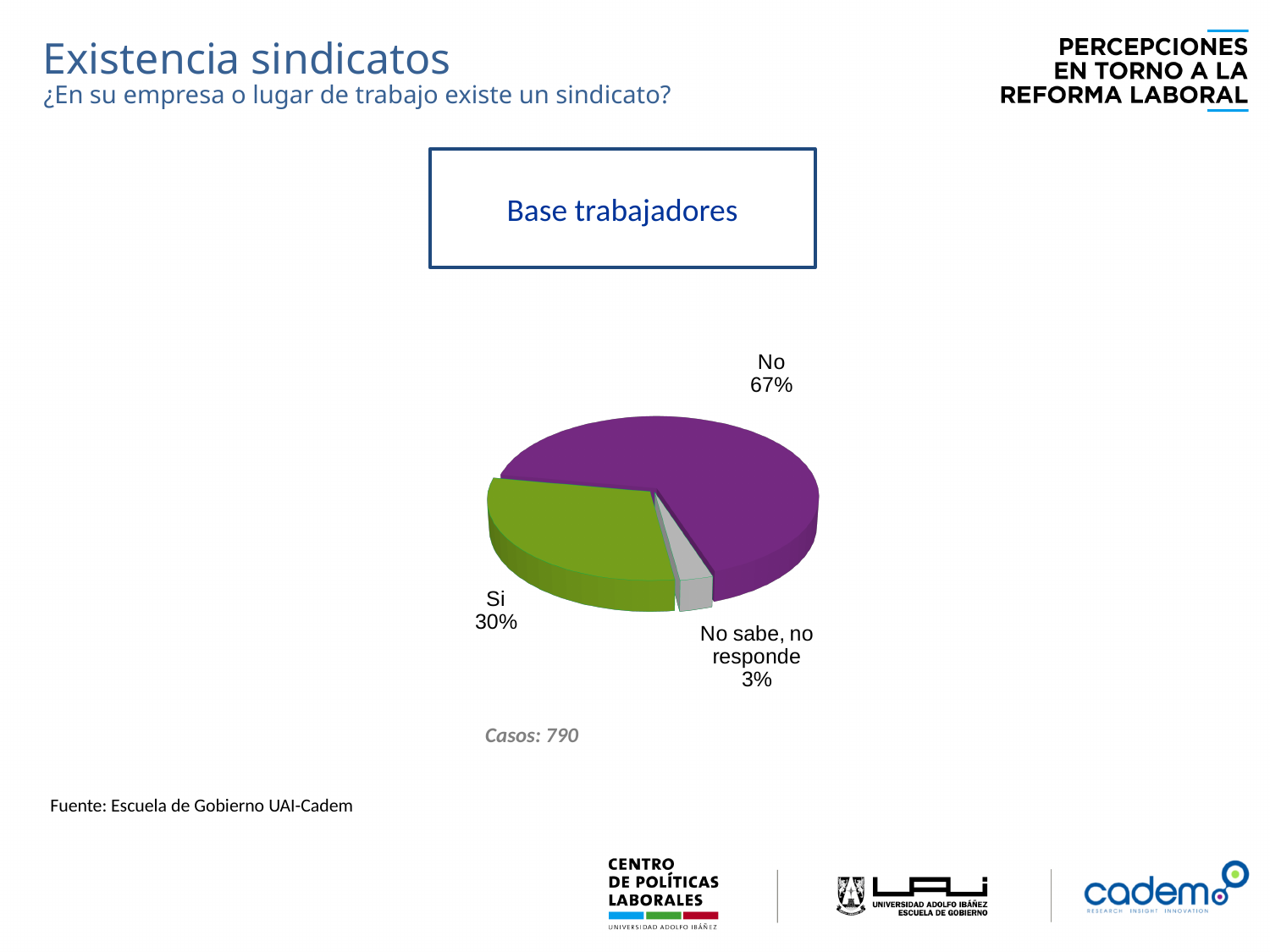
What kind of chart is shown on the slide? Pie chart Which response has the smallest share of the pie? No sabe, no responde Which response has the largest share of the pie? No What is the difference in percentage points between the "No" and "Si" slices? 37 How many cases (Casos) does the chart report? 790 What colour is the "Si" slice? Green What percentage of respondents answered "Si"? 30% What share of the pie does the "No" slice represent? 67% Which is larger, the "Si" slice or the "No sabe, no responde" slice? Si How many slices does the pie chart have? 3 What percentage of respondents answered "No"? 67% What percentage of respondents answered "No sabe, no responde"? 3%